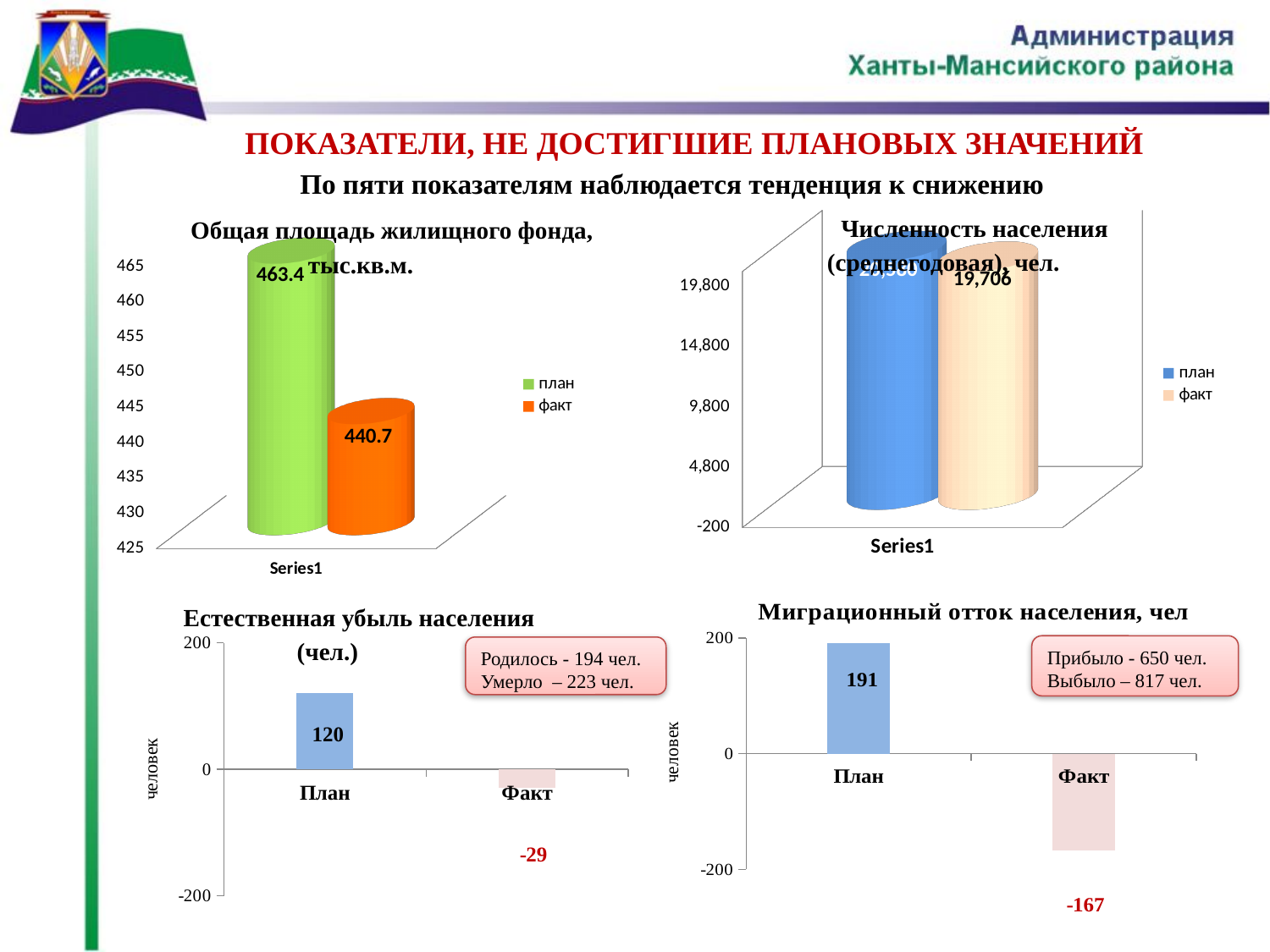
In the chart 'Миграционный отток населения, чел', what is the value for Факт? -167 How many categories are shown on the x axis of the chart 'Естественная убыль населения (чел.)'? 2 In the chart 'Общая площадь жилищного фонда, тыс.кв.м.', what is the value for план? 463.4 In the chart 'Общая площадь жилищного фонда, тыс.кв.м.', which is larger, план or факт? план In the chart 'Естественная убыль населения (чел.)', what is the value for Факт? -29 In the chart 'Естественная убыль населения (чел.)', what is the value for План? 120 What kind of chart is 'Миграционный отток населения, чел'? bar chart In the chart 'Общая площадь жилищного фонда, тыс.кв.м.', what is the difference between план and факт? 22.7 In the chart 'Миграционный отток населения, чел', what is the difference between План and Факт? 358 How many series does the legend list in the chart 'Численность населения (среднегодовая), чел.'? 2 In the chart 'Общая площадь жилищного фонда, тыс.кв.м.', what is the value for факт? 440.7 In the chart 'Численность населения (среднегодовая), чел.', what is the value for факт? 19,706